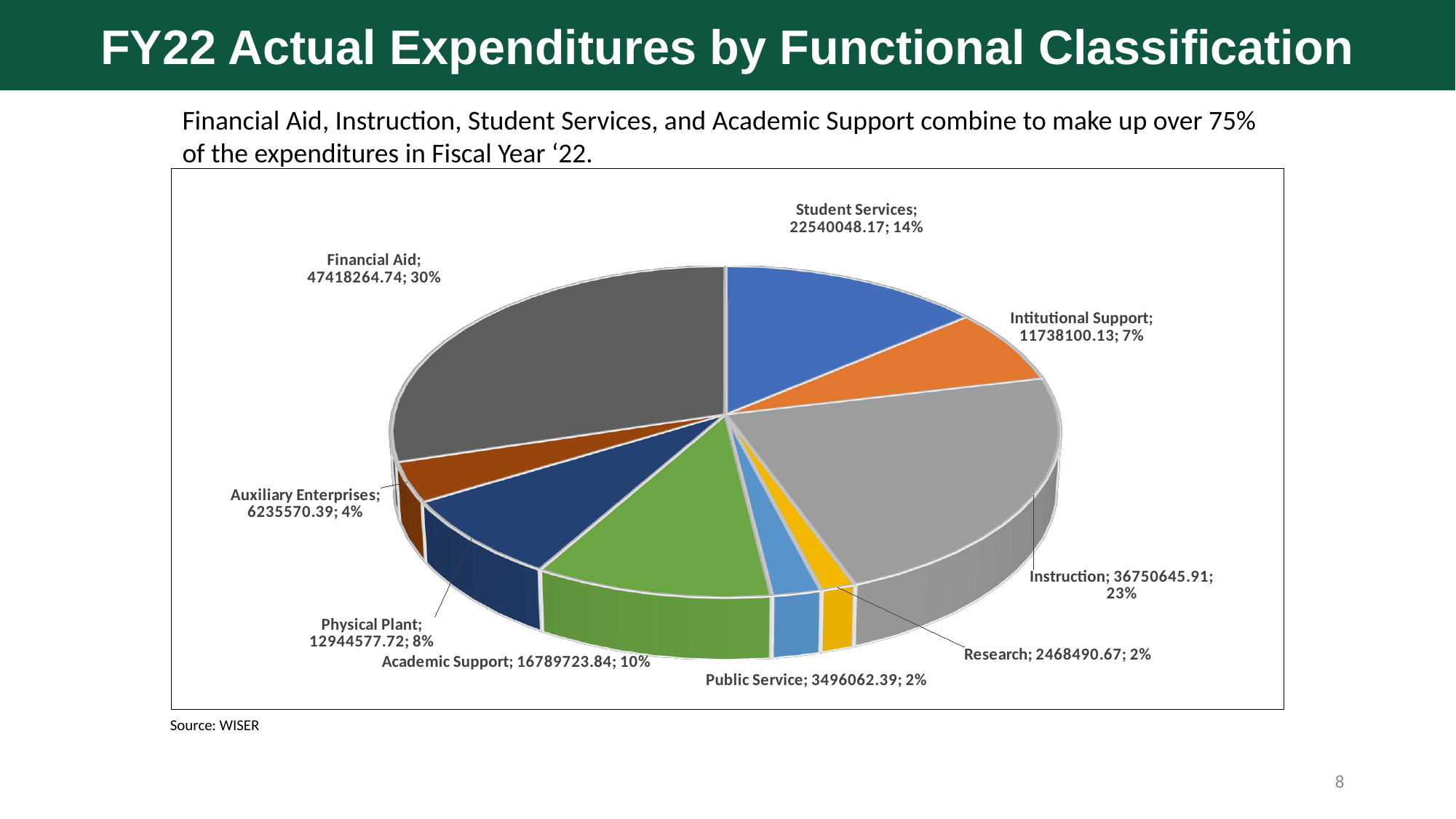
Which category has the smallest expenditure? Research How many categories does the pie chart show? 9 What is the value for Physical Plant? 12944577.72 What is the value for Student Services? 22540048.17 Which is larger, Physical Plant or Academic Support? Academic Support What share of the pie does Instruction represent? 23% What is the value for Financial Aid? 47418264.74 What share of the pie does Academic Support represent? 10% What is the difference between the Financial Aid and Instruction values? 10667618.83 Which category has the largest expenditure? Financial Aid What is the title of the slide containing the chart? FY22 Actual Expenditures by Functional Classification What kind of chart is shown on the slide? Pie chart